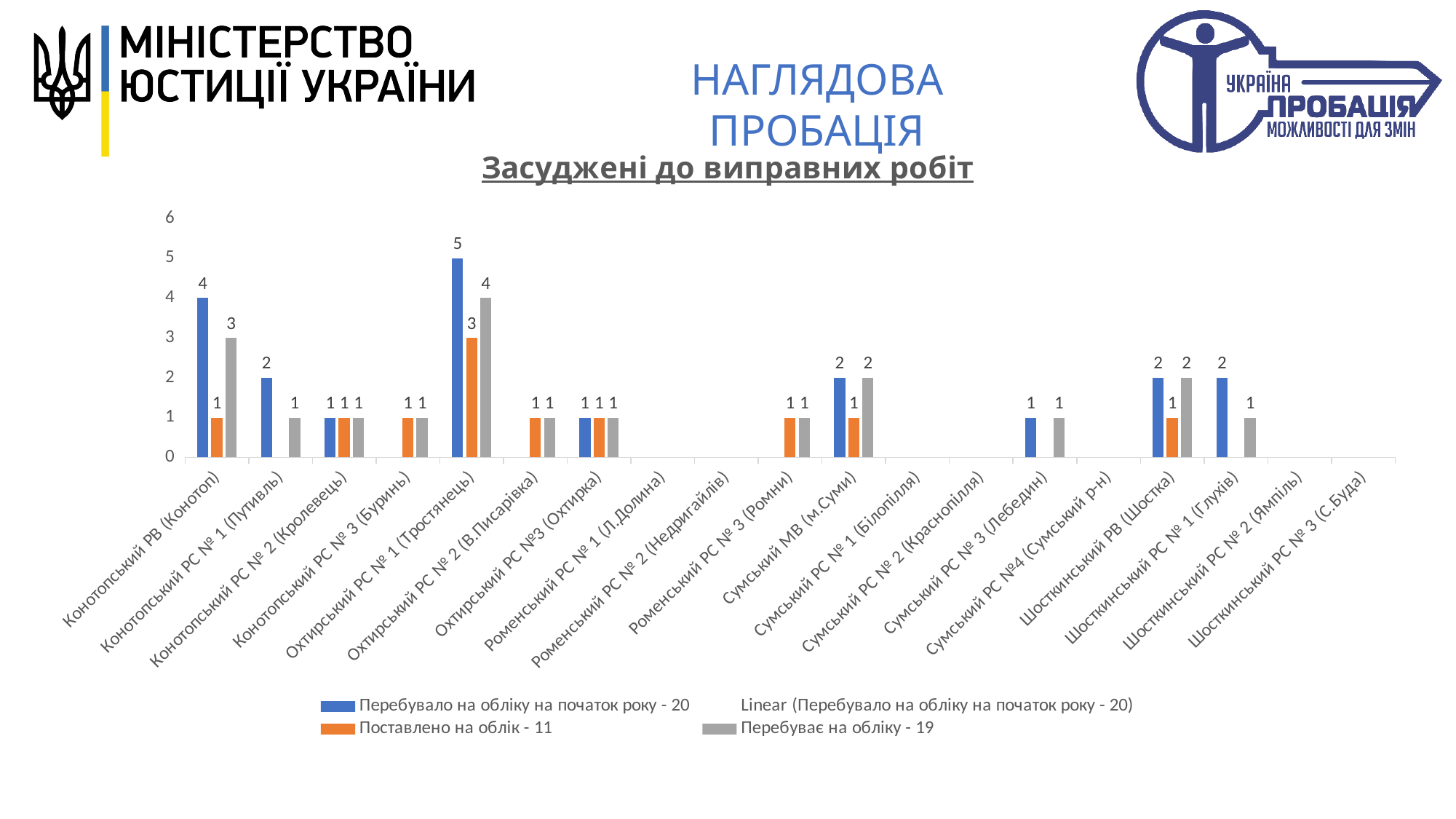
What is the value of 'Поставлено на облік' for Охтирський РС № 1 (Тростянець)? 3 What is the difference between 'Перебувало на обліку на початок року' and 'Перебуває на обліку' for Охтирський РС № 1 (Тростянець)? 1 How many entries does the legend list? 4 How many categories are shown on the x axis? 19 What is the difference between 'Перебувало на обліку на початок року' for Конотопський РВ (Конотоп) and for Конотопський РС № 1 (Путивль)? 2 Which category has the highest value for 'Перебувало на обліку на початок року'? Охтирський РС № 1 (Тростянець) What is the value of 'Перебувало на обліку на початок року' for Сумський МВ (м.Суми)? 2 Which category has the highest value for 'Перебуває на обліку'? Охтирський РС № 1 (Тростянець) What is the value of 'Перебуває на обліку' for Конотопський РВ (Конотоп)? 3 What is the value of 'Перебувало на обліку на початок року' for Охтирський РС № 1 (Тростянець)? 5 Which is larger: 'Перебувало на обліку на початок року' for Конотопський РВ (Конотоп) or for Шосткинський РВ (Шостка)? Конотопський РВ (Конотоп) What type of chart is shown on the slide? Bar chart